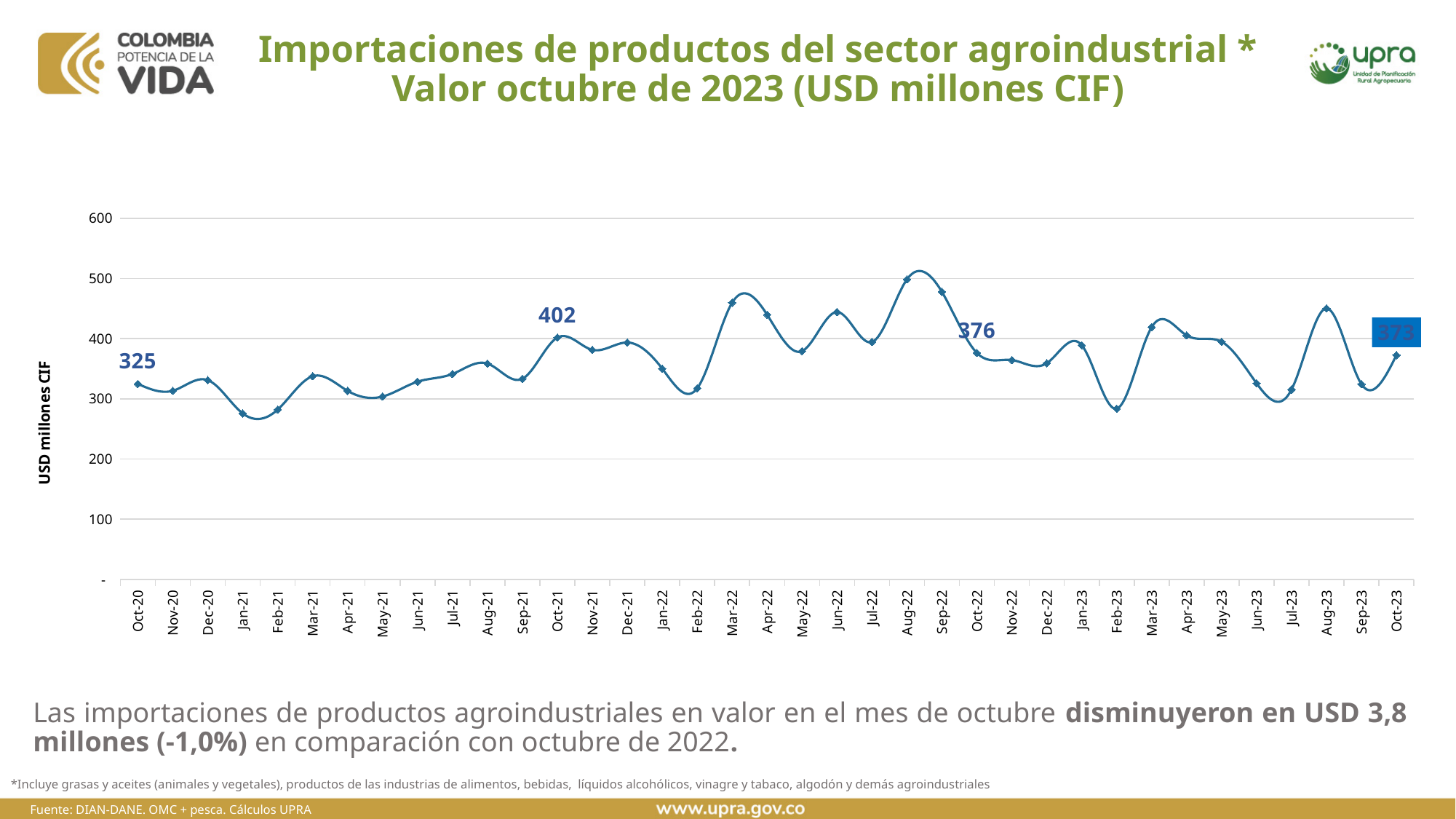
Which month has the highest value on the chart? Aug-22 What is the value for Oct-20? 325 What is the difference between the values for Oct-23 and Oct-20? 48 Is the value for Jan-21 greater or less than 300? less What is the value for Oct-21? 402 How many monthly data points are plotted on the chart? 37 What is the difference between the values for Oct-21 and Oct-22? 26 Is the value for Aug-22 greater or less than 400? greater Which is larger, the value for Oct-21 or the value for Oct-22? Oct-21 What is the value for Oct-23? 373 What kind of chart is shown on the slide? Line chart What is the value for Oct-22? 376